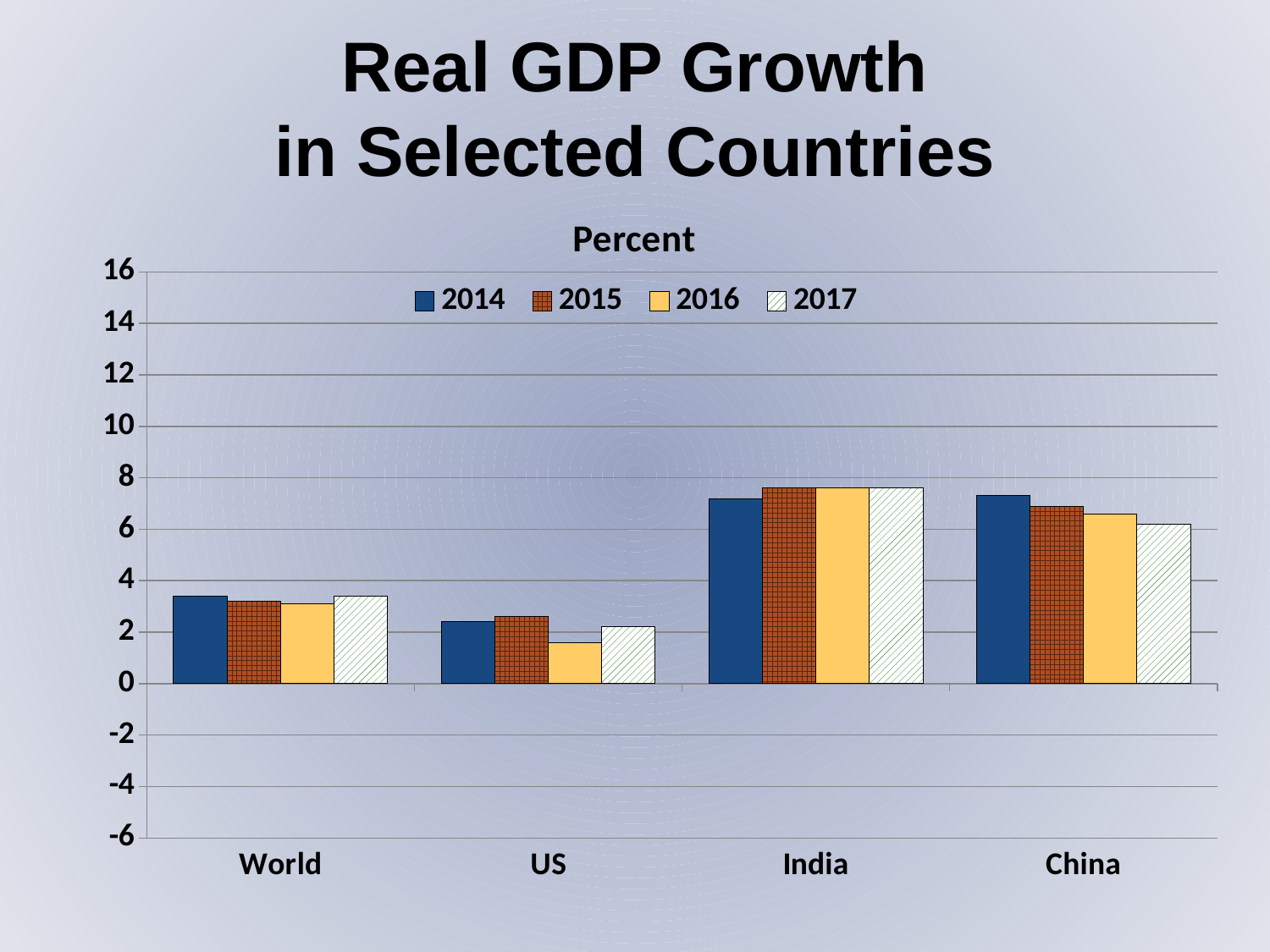
Do the values for China rise or fall from 2014 to 2017? fall What kind of chart is shown on the slide? bar chart Is the value for China in 2017 greater or less than 8? less How many countries or regions are shown on the x axis? 4 Is the value for US in 2016 greater or less than 2? less Which country or region has the lowest value for 2016? US Is the value for World in 2014 greater or less than 4? less Which is larger in 2014, the value for India or the value for US? India Which country or region has the highest value for 2017? India How many series does the legend list? 4 For China, which is larger, the 2014 value or the 2017 value? 2014